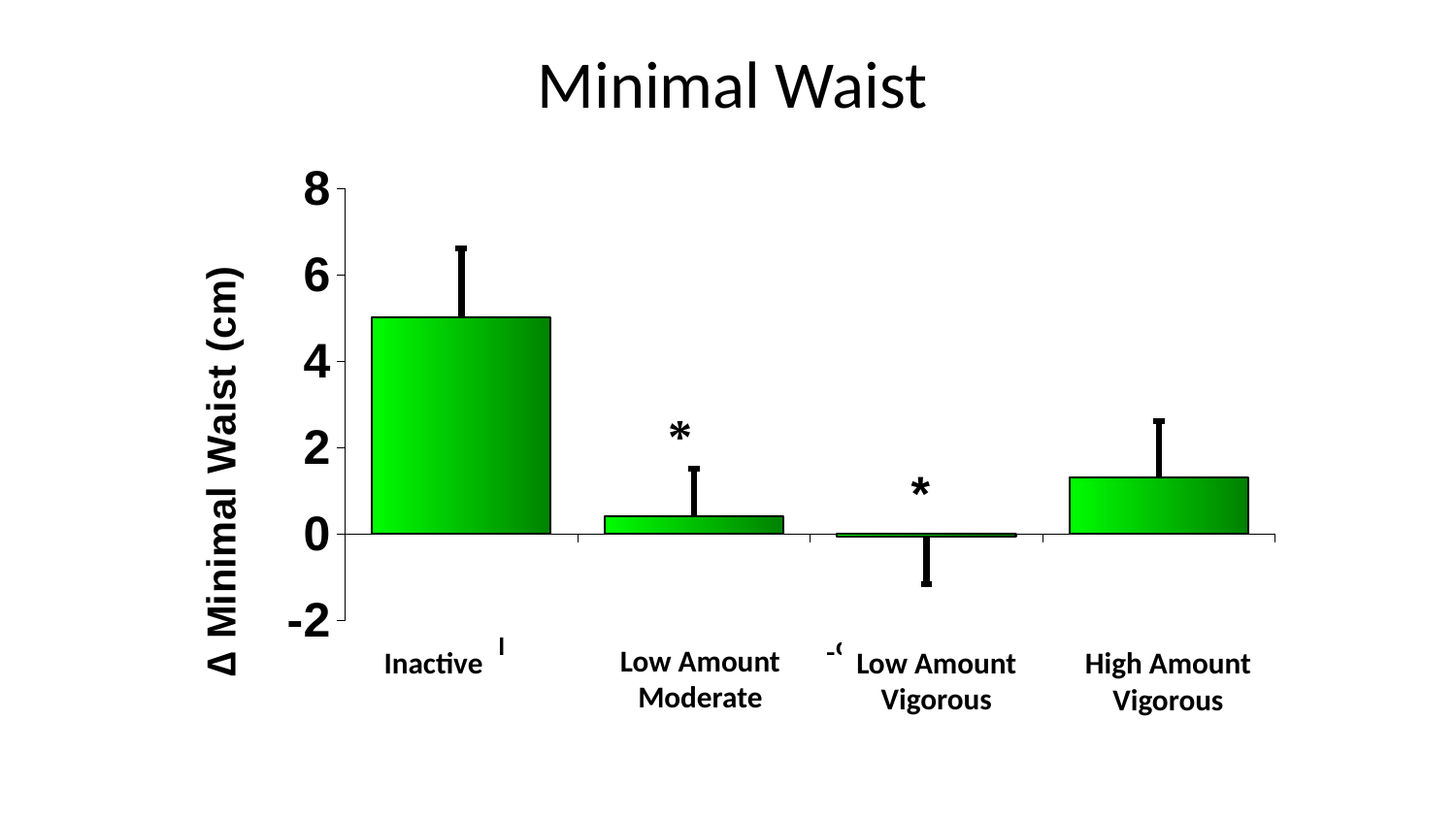
Which is larger, the value for Inactive or the value for High Amount Vigorous? Inactive Is the value for Inactive greater or less than 6? less Which category has the highest value? Inactive Which is larger, the value for High Amount Vigorous or the value for Low Amount Moderate? High Amount Vigorous What kind of chart is shown on the slide? bar chart Is the value for Inactive greater or less than 4? greater How many categories are plotted on the x axis? 4 What is the label on the vertical axis of the chart? Δ Minimal Waist (cm) What is the title of the chart? Minimal Waist Which category has the lowest value? Low Amount Vigorous Is the value for Low Amount Moderate greater or less than 2? less